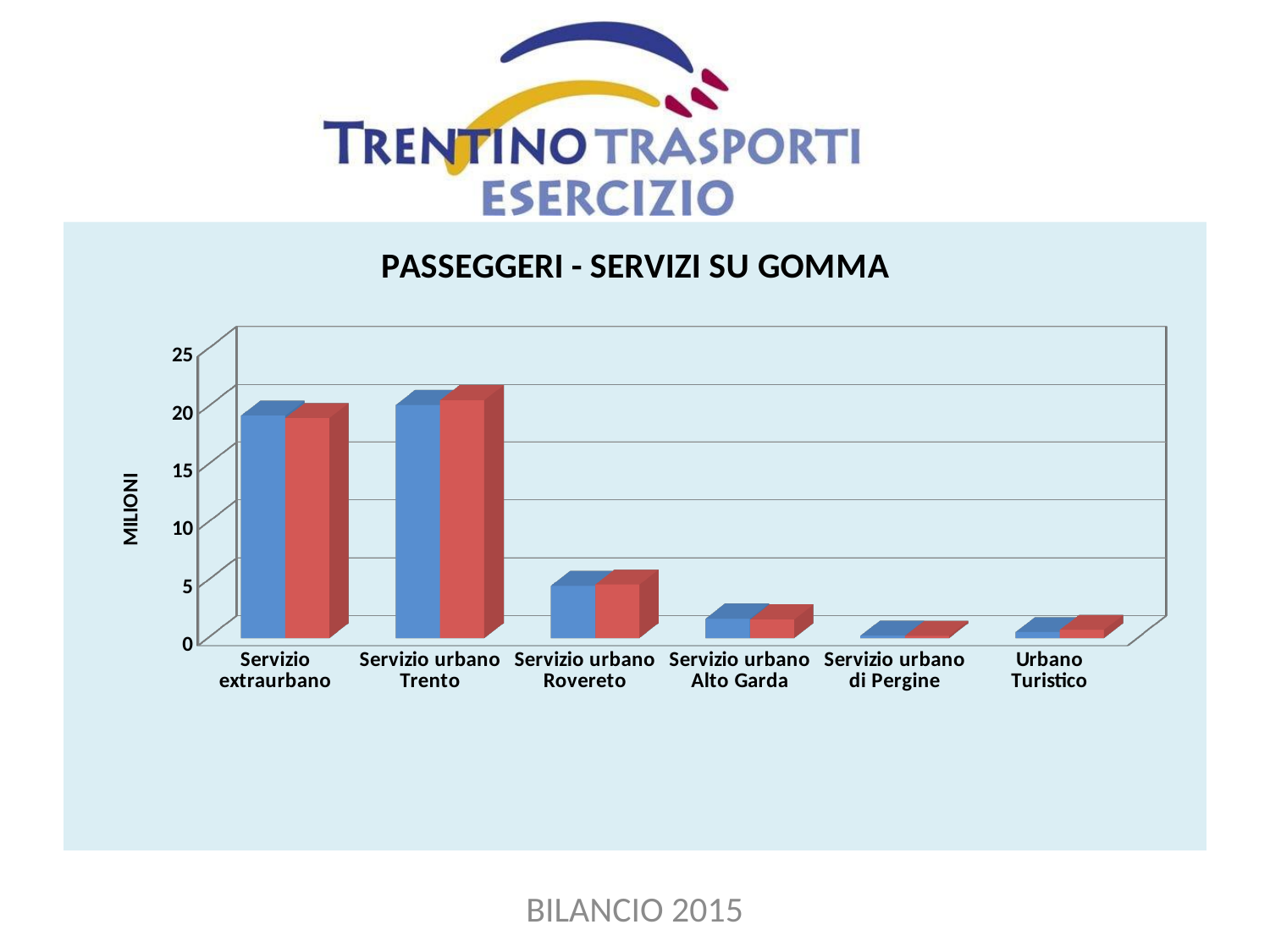
Is the value for Servizio urbano Alto Garda greater or less than 5? less What kind of chart is shown on the slide? bar chart Is the value for Servizio urbano Trento greater or less than 25? less Which is larger, the value for Servizio urbano Trento or the value for Servizio urbano Rovereto? Servizio urbano Trento Which category has the lowest bars in the chart? Servizio urbano di Pergine Which category has the highest bars in the chart? Servizio urbano Trento Is the value for Servizio urbano Rovereto greater or less than 10? less Which is larger, the value for Servizio urbano Alto Garda or the value for Servizio extraurbano? Servizio extraurbano How many categories are shown on the x axis of the chart? 6 What is the label on the vertical axis of the chart? MILIONI What is the title of the chart? PASSEGGERI - SERVIZI SU GOMMA